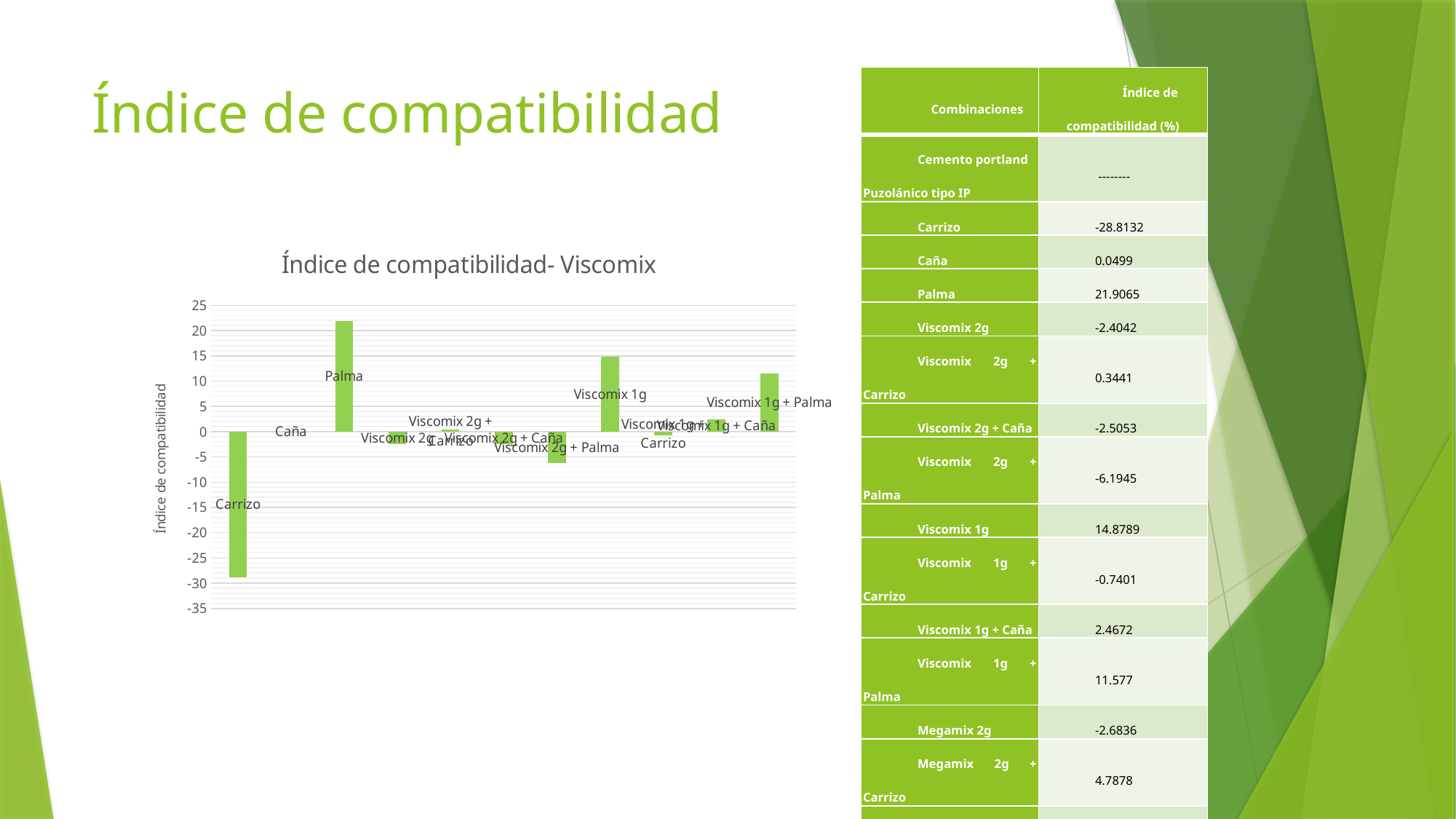
Is the value for Viscomix 2g + Palma greater or less than 0? less How many categories (bars) are plotted in the chart? 11 Is the value for Carrizo greater or less than -25? less Which is larger, the value for Palma or the value for Viscomix 1g? Palma What is the title of the chart? Índice de compatibilidad- Viscomix Which category has the highest value in the chart? Palma Which category has the lowest value in the chart? Carrizo Which is larger, the value for Viscomix 1g or the value for Viscomix 1g + Palma? Viscomix 1g Is the value for Viscomix 1g greater or less than 10? greater What is the label on the vertical axis of the chart? Índice de compatibilidad What type of chart is shown on the slide? bar chart